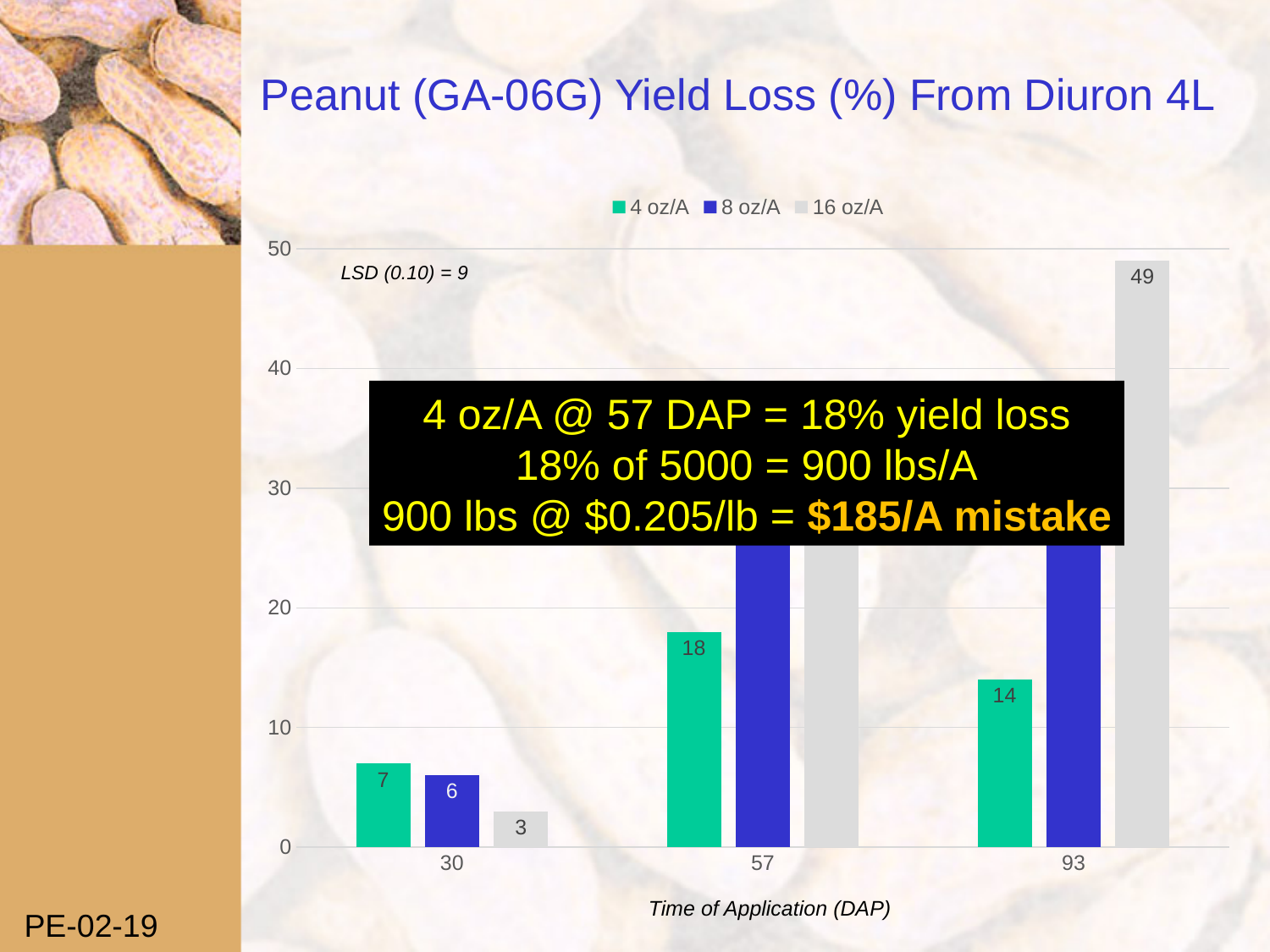
What is the yield loss (%) for 4 oz/A at 30 DAP? 7 What is the yield loss (%) for 16 oz/A at 30 DAP? 3 What is the yield loss (%) for 4 oz/A at 57 DAP? 18 Which bar shows the highest yield loss on the chart? 16 oz/A at 93 DAP How many application timings (DAP) are shown on the x axis? 3 Which has the larger yield loss for 4 oz/A: 57 DAP or 93 DAP? 57 DAP What is the difference in yield loss between 4 oz/A at 57 DAP and 4 oz/A at 30 DAP? 11 What is the yield loss (%) for 16 oz/A at 93 DAP? 49 How many series does the legend list? 3 What is the yield loss (%) for 8 oz/A at 30 DAP? 6 What is the title of the x axis? Time of Application (DAP) Is the yield loss for 8 oz/A at 57 DAP greater or less than 20? greater